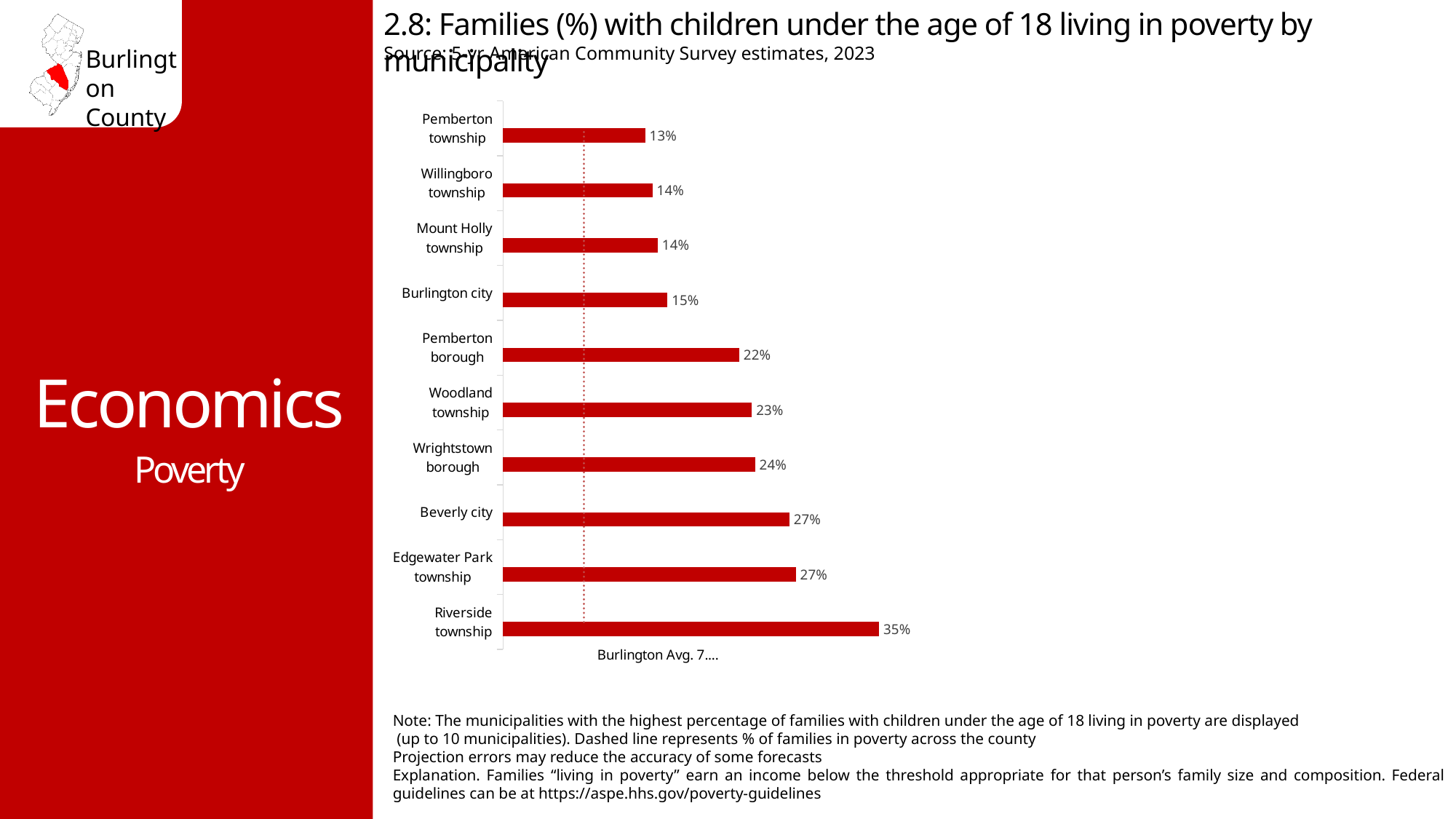
Which municipality has the lowest percentage shown on the chart? Pemberton township What is the difference between the values for Riverside township and Pemberton township? 22% What is the value shown for Pemberton borough? 22% What percentage of families with children under 18 are living in poverty in Riverside township? 35% What is the difference between the values for Beverly city and Wrightstown borough? 3% What does the dashed vertical line on the chart represent? Burlington County average % of families in poverty How many municipalities are shown on the chart? 10 What is the value shown for Burlington city? 15% Do the values increase or decrease going from the top bar to the bottom bar? Increase What kind of chart is shown on the slide? Bar chart Which has a higher value, Woodland township or Willingboro township? Woodland township Which municipality has the highest percentage of families with children under 18 living in poverty? Riverside township